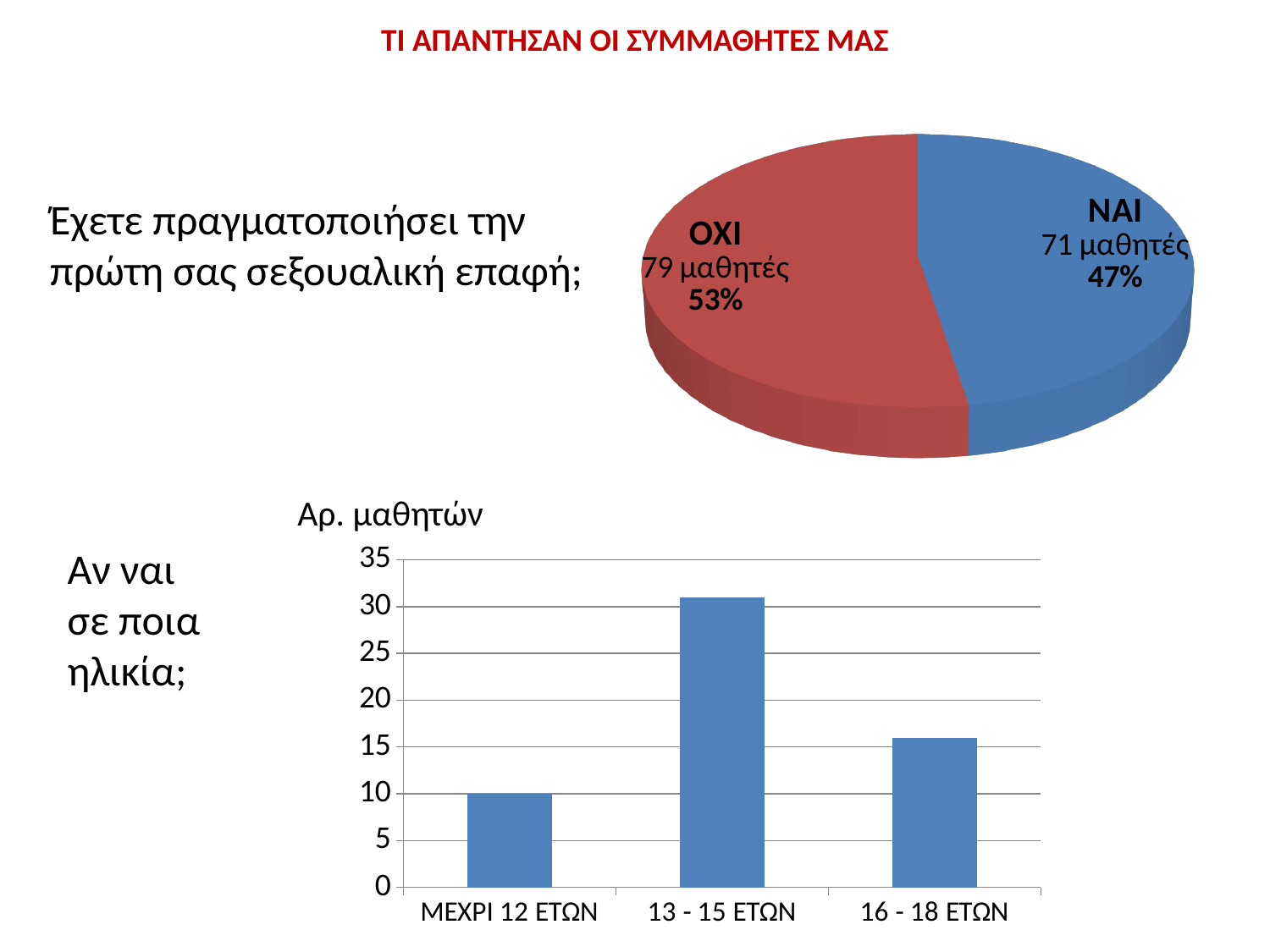
In the pie chart at the top, which answer has the larger slice, ΝΑΙ or ΟΧΙ? ΟΧΙ In the bottom bar chart, which age category has the highest number of students? 13 - 15 ΕΤΩΝ In the pie chart at the top, how many slices does the pie have? 2 In the pie chart at the top, how many students answered ΝΑΙ? 71 μαθητές In the pie chart at the top, what percentage of students answered ΟΧΙ? 53% In the bottom bar chart, what is the value for ΜΕΧΡΙ 12 ΕΤΩΝ? 10 In the pie chart at the top, what is the difference in number of students between ΟΧΙ and ΝΑΙ? 8 μαθητές In the pie chart at the top, what percentage of students answered ΝΑΙ? 47% What kind of chart is the bottom chart on the slide? Bar chart In the bottom bar chart, is the value for 13 - 15 ΕΤΩΝ greater or less than 30? greater In the bottom bar chart, how many age categories are shown on the x axis? 3 In the pie chart at the top, what colour is the ΝΑΙ slice? Blue